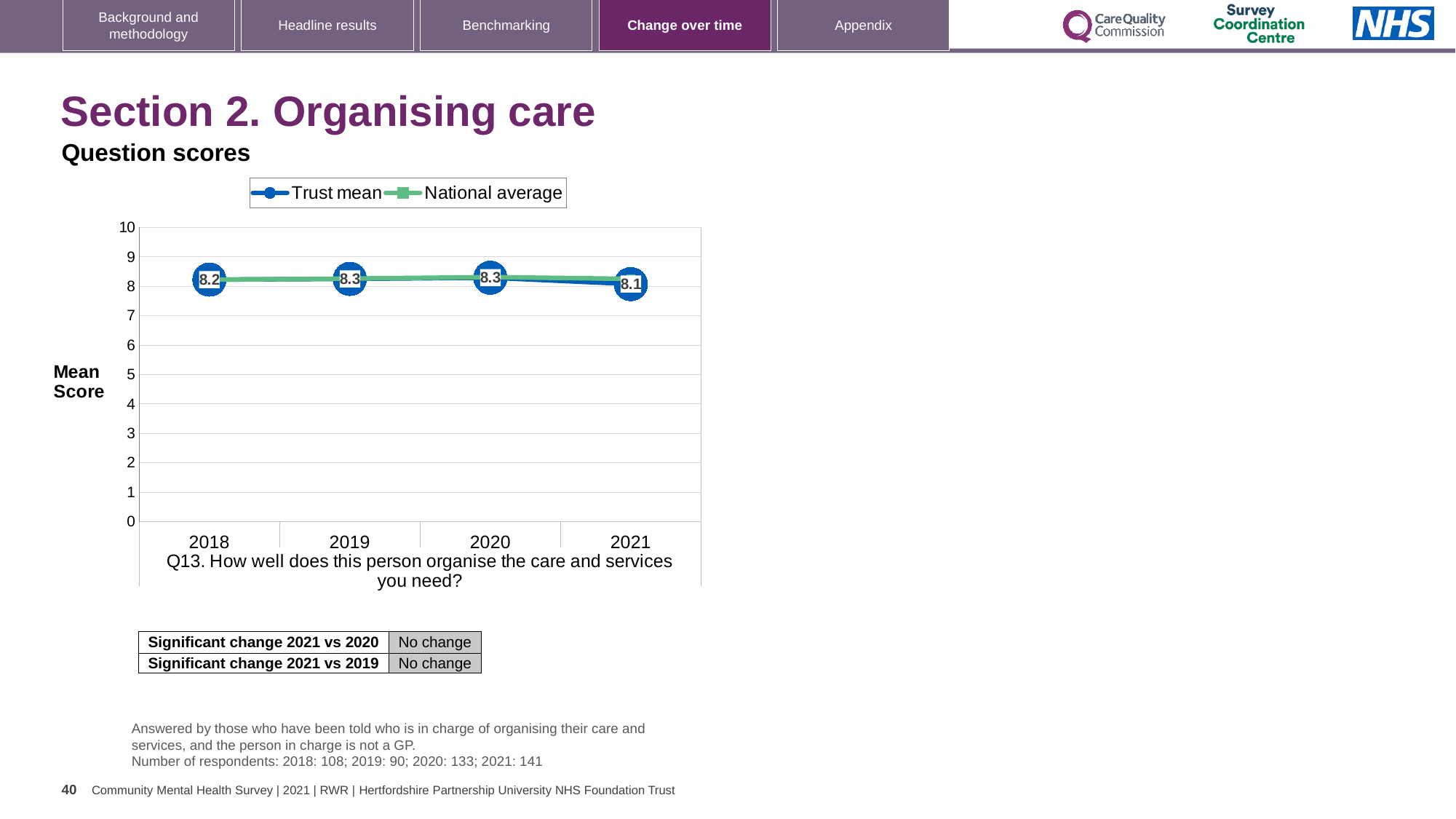
What is the Trust mean score for 2018? 8.2 How many series does the legend list? 2 Does the Trust mean score rise or fall from 2020 to 2021? fall What is the label on the y axis of the chart? Mean Score How many years are plotted on the x axis? 4 Which is larger, the Trust mean score for 2018 or for 2021? 2018 What is the Trust mean score for 2021? 8.1 What is the Trust mean score for 2019? 8.3 What is the difference between the Trust mean scores for 2020 and 2021? 0.2 In which year is the Trust mean score lowest? 2021 What kind of chart is shown? line chart Is the National average value for 2021 greater or less than 5? greater